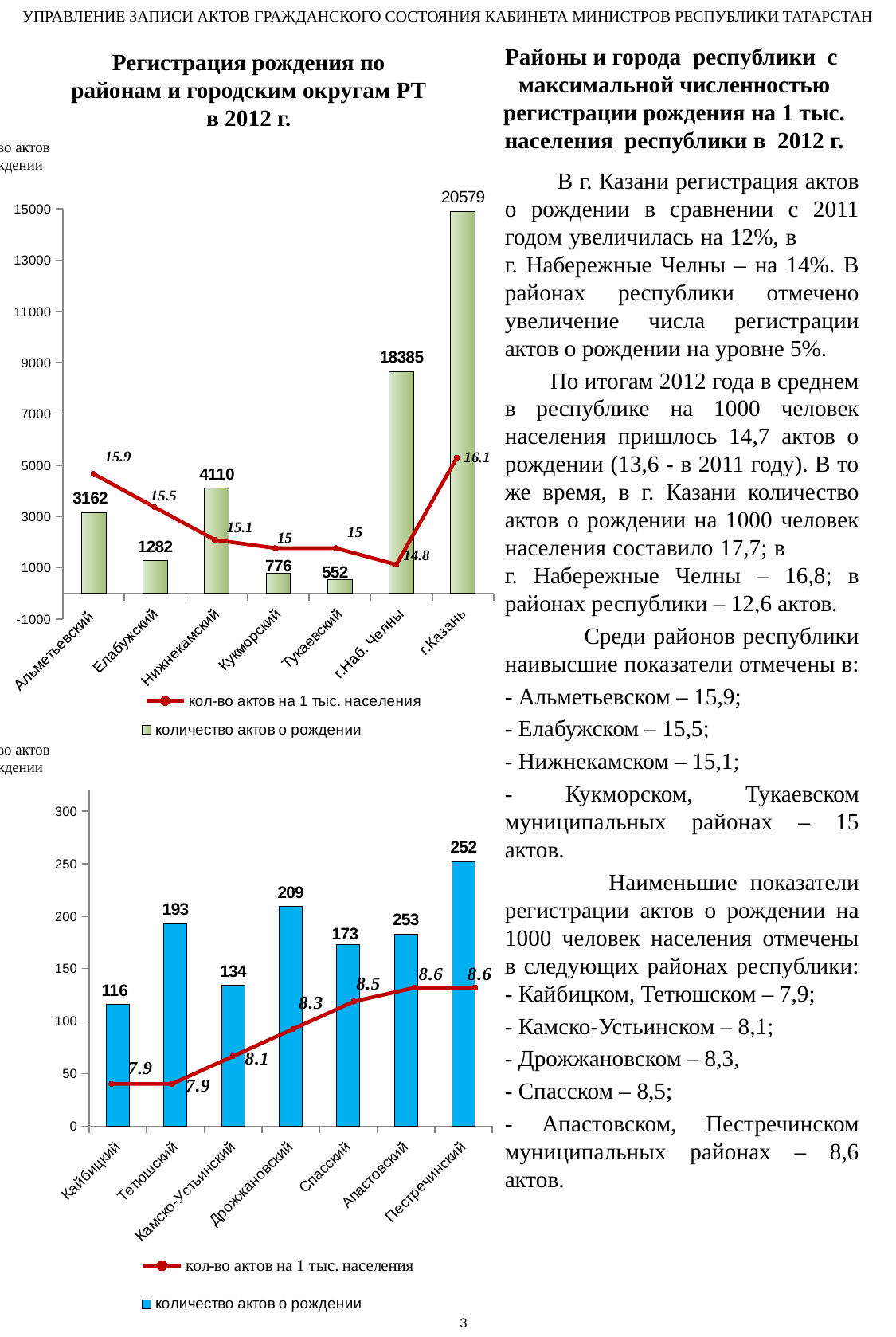
On the top chart, what is the difference in the number of birth registration acts between г.Казань and г.Наб. Челны? 2194 On the bottom chart, does the 'кол-во актов на 1 тыс. населения' line rise or fall from Кайбицкий to Пестречинский? rise On the top chart, which category has the lowest number of birth registration acts? Тукаевский On the top chart, how many categories are shown on the x axis? 7 On the top chart, which is larger: the number of birth registration acts for Нижнекамский or for Альметьевский? Нижнекамский On the top chart, how many series does the legend list? 2 On the top chart, what is the value of 'кол-во актов на 1 тыс. населения' for Альметьевский? 15.9 On the bottom chart, what is the number of birth registration acts for Дрожжановский? 209 On the bottom chart, what is the value of 'кол-во актов на 1 тыс. населения' for Спасский? 8.5 On the top chart, what is the number of birth registration acts (количество актов о рождении) for г.Казань? 20579 What type of chart is the bottom chart? Combined bar and line chart On the bottom chart, which category has the lowest number of birth registration acts? Кайбицкий